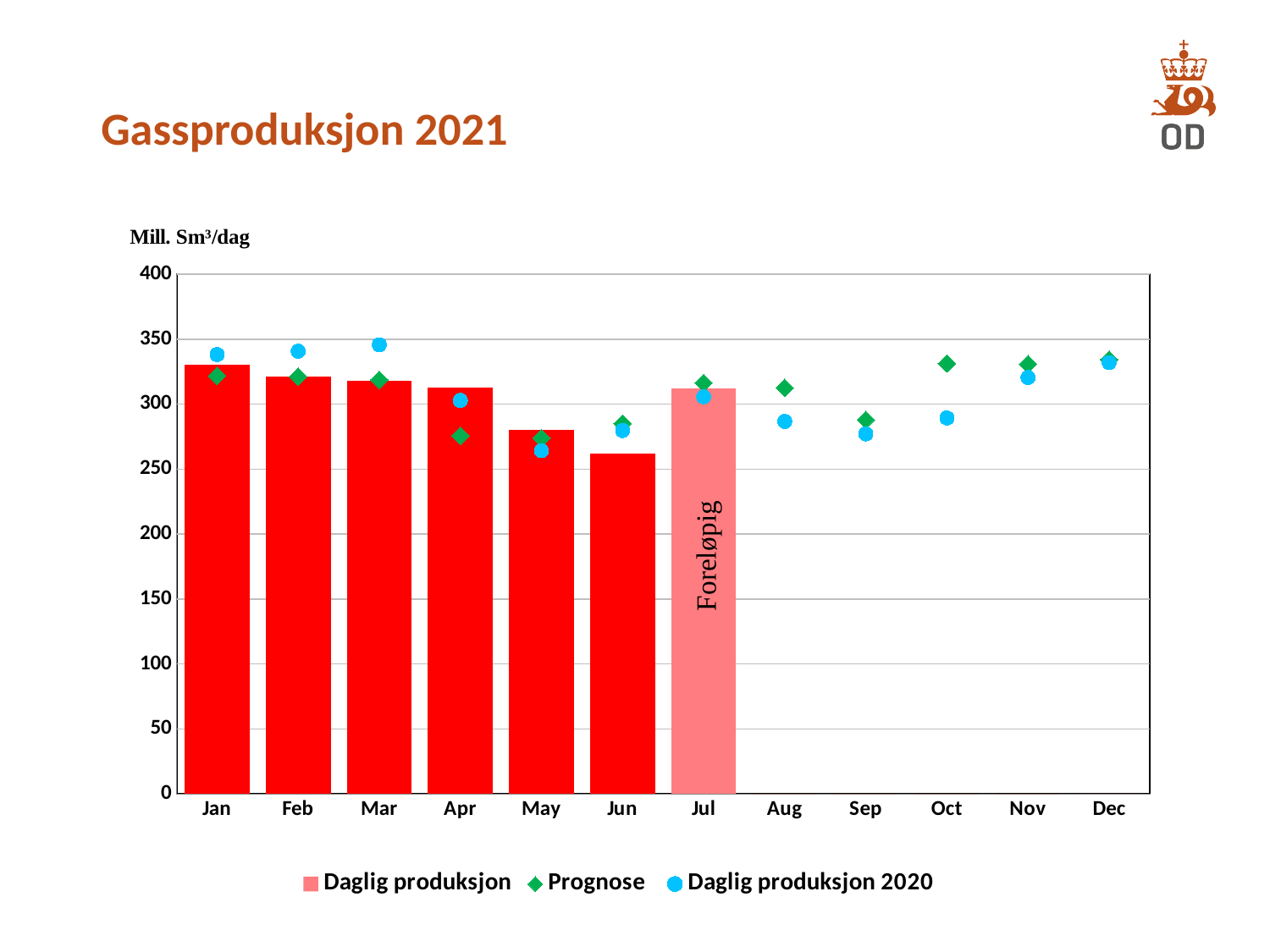
Is the Daglig produksjon 2020 value for Sep greater or less than 300? less How many series does the legend list? 3 Is the Daglig produksjon value for Jan greater or less than 300? greater Which month has the highest Daglig produksjon bar? Jan How many months are shown on the x axis? 12 What kind of chart is shown on the slide? bar chart Is the Daglig produksjon value for Jun greater or less than 300? less Do the Daglig produksjon bars rise or fall from Jan to Jun? fall What is the title of the chart? Gassproduksjon 2021 Which is larger, the Daglig produksjon bar for May or for Jun? May Which month has the lowest Daglig produksjon bar? Jun